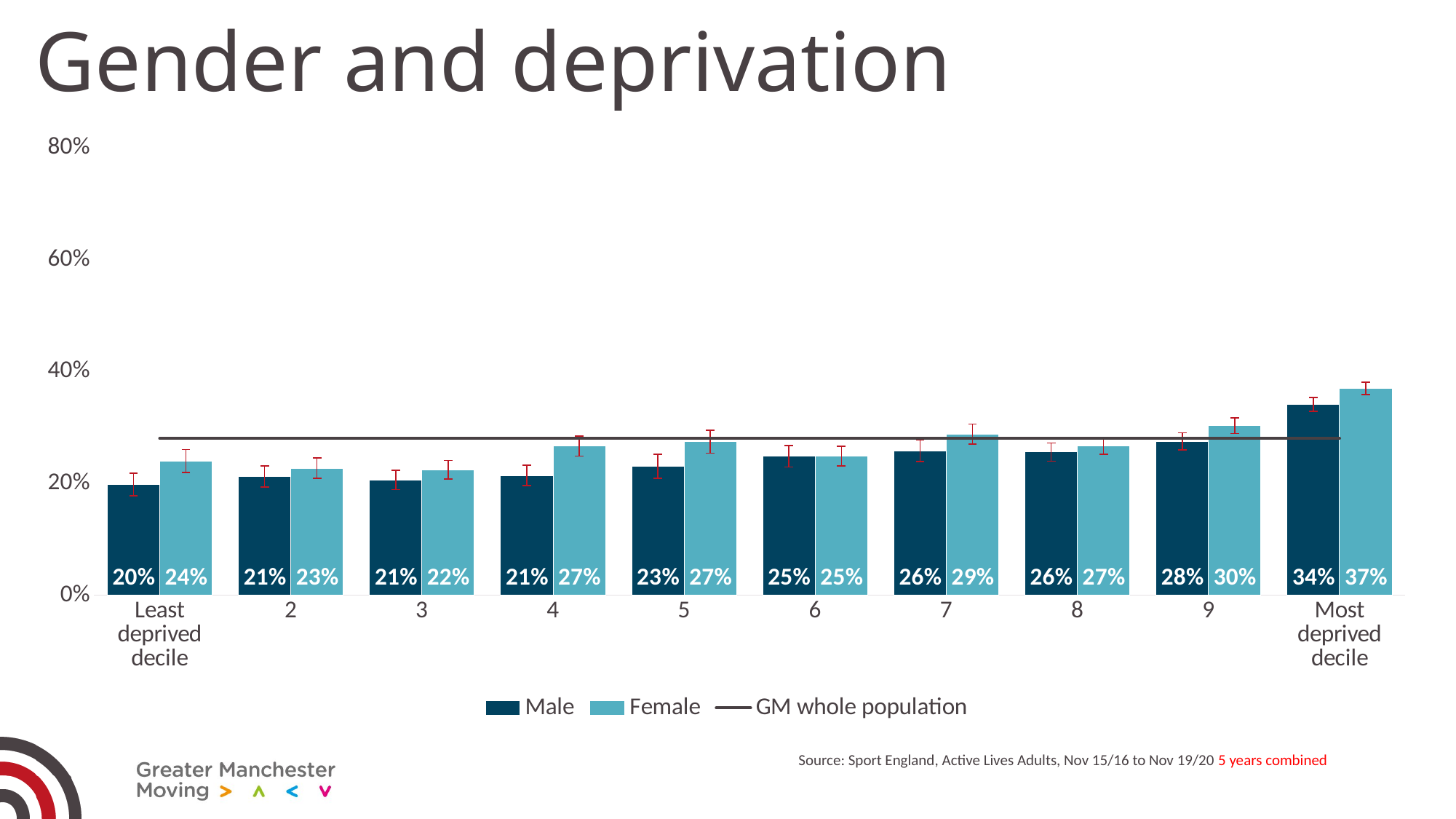
Which is larger for decile 9, the Male value or the Female value? Female How many deciles are shown on the x axis? 10 Which decile has the highest Female value? Most deprived decile How many entries does the legend list? 3 Which decile has the lowest Male value? Least deprived decile Is the Female value for the Most deprived decile greater or less than 40%? less What is the Female value for decile 4? 27% What kind of chart is shown on the slide? bar chart Do the Male values generally rise or fall from the Least deprived decile to the Most deprived decile? rise What is the Male value for the Least deprived decile? 20% What is the difference between the Female and Male values for decile 4? 6% What is the Male value for the Most deprived decile? 34%